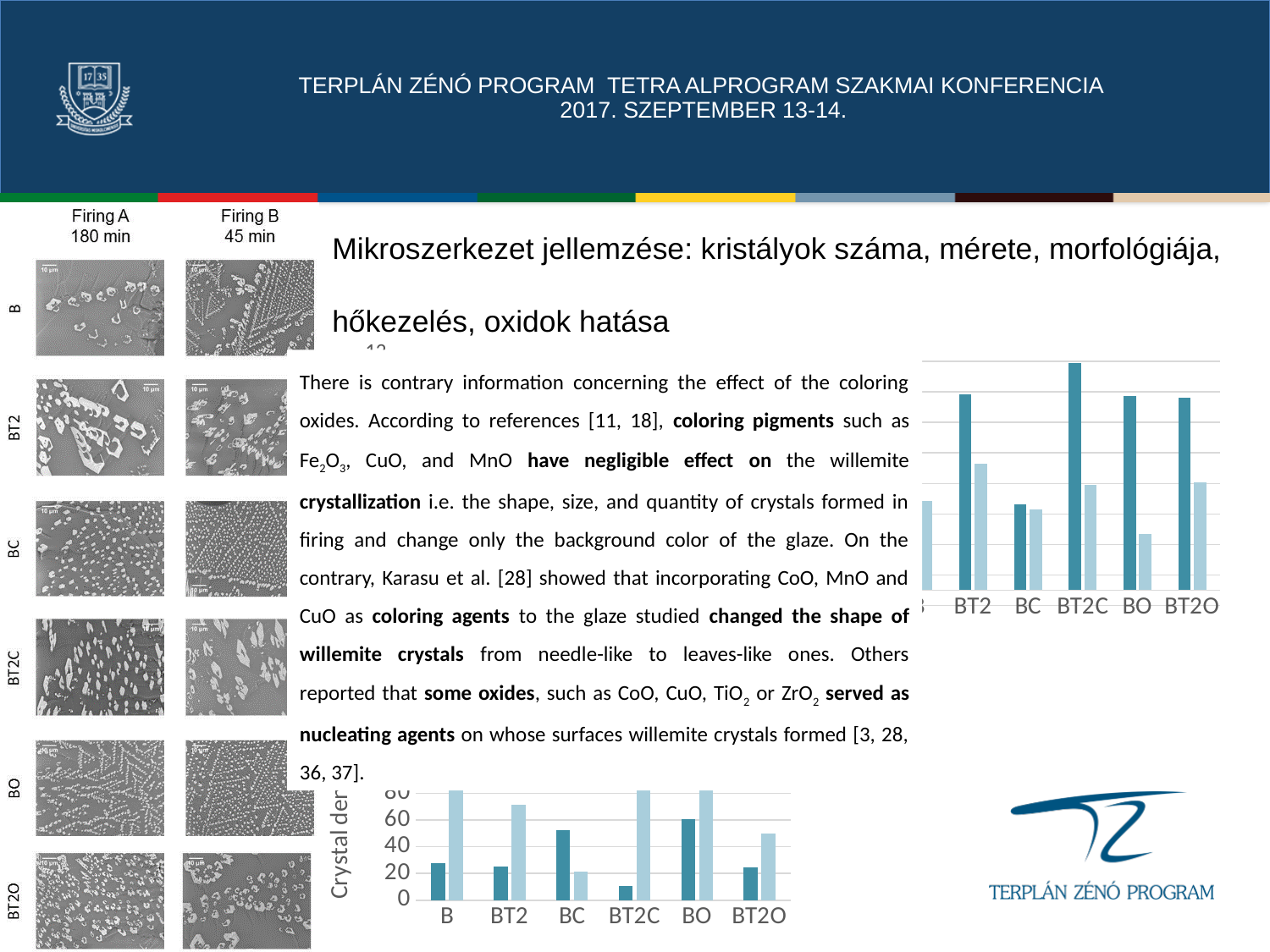
In the chart at the bottom of the slide, is the dark teal bar for BC greater or less than 40? greater In the chart on the right side of the slide, which category has the highest dark teal bar? BT2C In the chart on the right side of the slide, which category has the lowest dark teal bar? BC How many bars are plotted for each category in the chart at the bottom of the slide? 2 In the chart at the bottom of the slide, is the dark teal bar for BT2C greater or less than 20? less In the chart at the bottom of the slide, which category has the lowest dark teal bar? BT2C In the chart at the bottom of the slide, is the light blue bar for BT2 greater or less than 60? greater In the chart at the bottom of the slide, which category has the highest dark teal bar? BO How many categories are shown on the x axis of the chart at the bottom of the slide? 6 What kind of chart is the chart at the bottom of the slide? bar chart In the chart at the bottom of the slide, is the dark teal bar larger for BC or for BT2C? BC